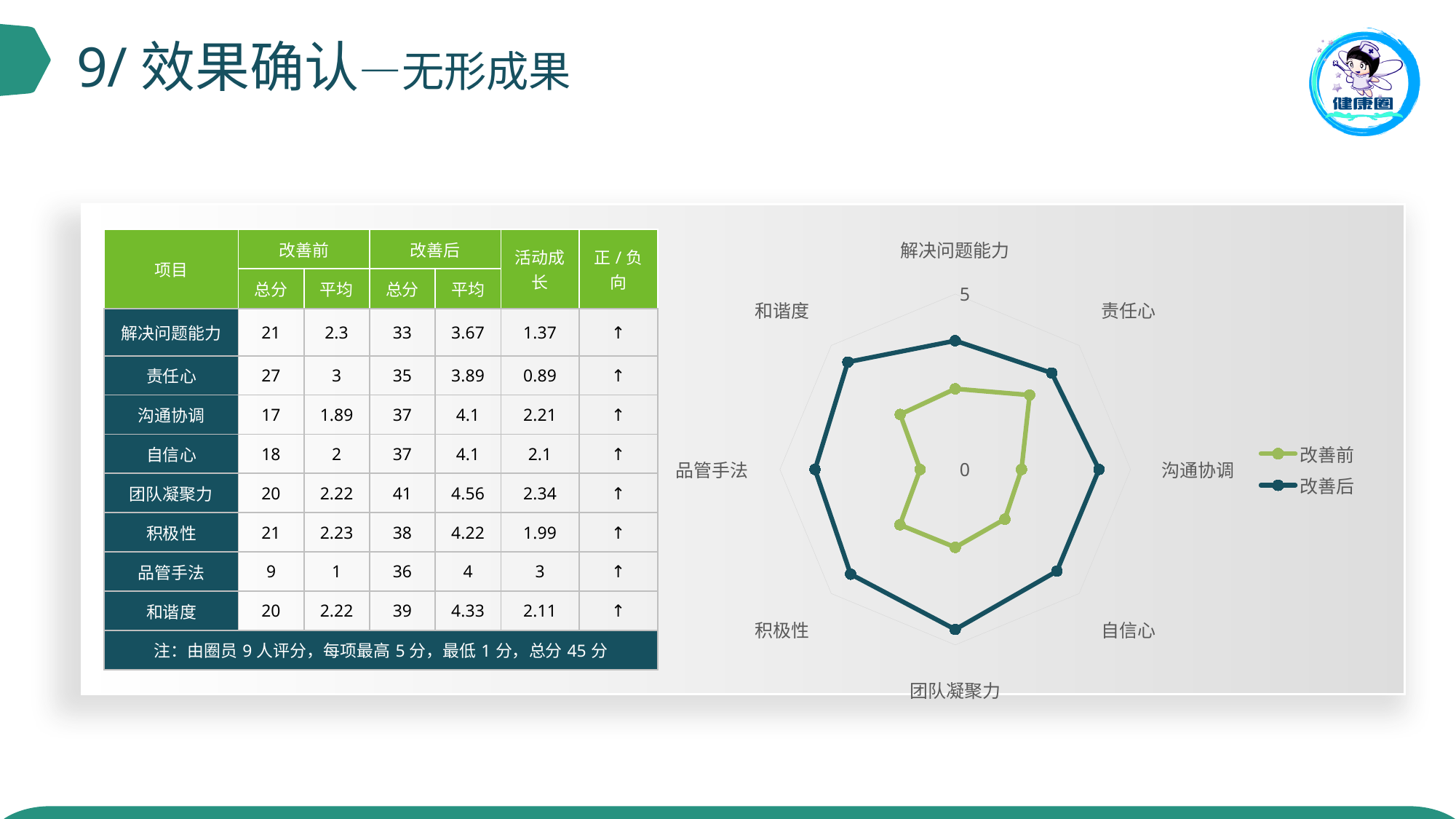
Which series in the radar chart is drawn in dark teal? 改善后 What kind of chart is shown on the right of the slide? radar chart In the radar chart, which series has the larger value for 沟通协调, 改善前 or 改善后? 改善后 How many categories (axes) does the radar chart have? 8 What are the two series named in the radar chart legend? 改善前, 改善后 In the radar chart, which category has the larger 改善前 value, 责任心 or 品管手法? 责任心 Is the 改善后 value for 团队凝聚力 in the radar chart greater or less than 5? less How many series does the legend of the radar chart list? 2 According to the table, what is the 改善后 平均 value for 团队凝聚力? 4.56 Which category has the lowest value for the 改善前 series in the radar chart? 品管手法 Which category has the highest value for the 改善前 series in the radar chart? 责任心 According to the table, what is the 改善前 平均 value for 品管手法? 1